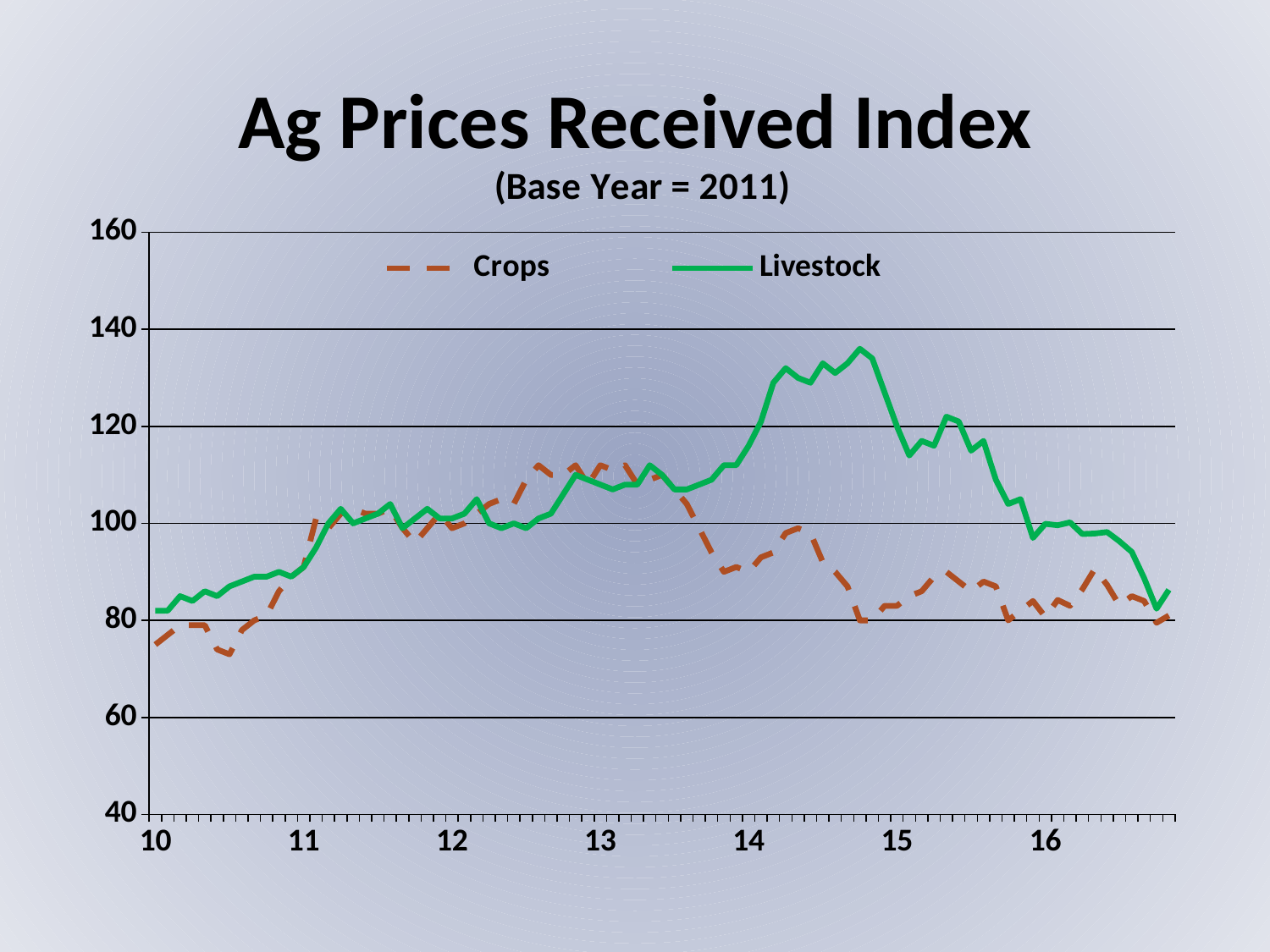
Is the peak value of the Crops series around 2013 greater or less than 100? greater Which series reaches the highest value anywhere on the chart? Livestock What is the title of the chart? Ag Prices Received Index Does the Livestock series rise or fall from its peak in late 2014 to the end of 2016? fall How many series does the legend list? 2 What base year is stated in the chart subtitle? 2011 Is the peak value of the Livestock series greater or less than 120? greater At the start of 2015, which series has the higher value, Crops or Livestock? Livestock Is the value for Crops at the start of 2015 greater or less than 100? less At the start of 2010, which series has the higher value, Crops or Livestock? Livestock What kind of chart is shown on the slide? line chart